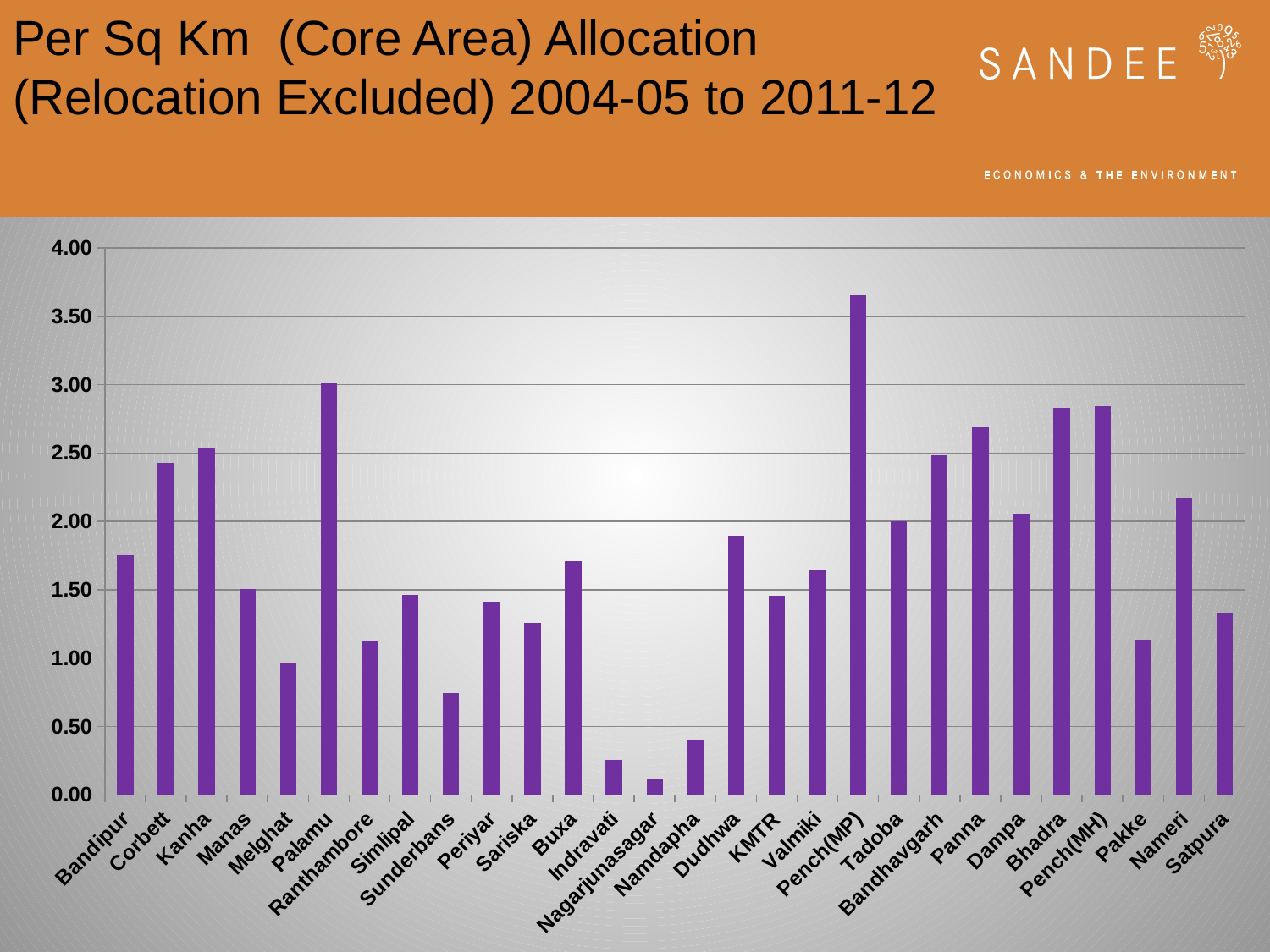
Which has the larger allocation, Palamu or Kanha? Palamu Which reserve has the highest per sq km allocation? Pench(MP) What kind of chart is shown on the slide? bar chart What colour are the bars in the chart? purple Is the value for Pench(MP) greater or less than 3.50? greater Which reserve has the lowest per sq km allocation? Nagarjunasagar Is the value for Bandipur greater or less than 1.50? greater Is the value for Sunderbans greater or less than 1.00? less Which has the larger allocation, Buxa or Sariska? Buxa How many tiger reserves (categories) are plotted on the x axis? 28